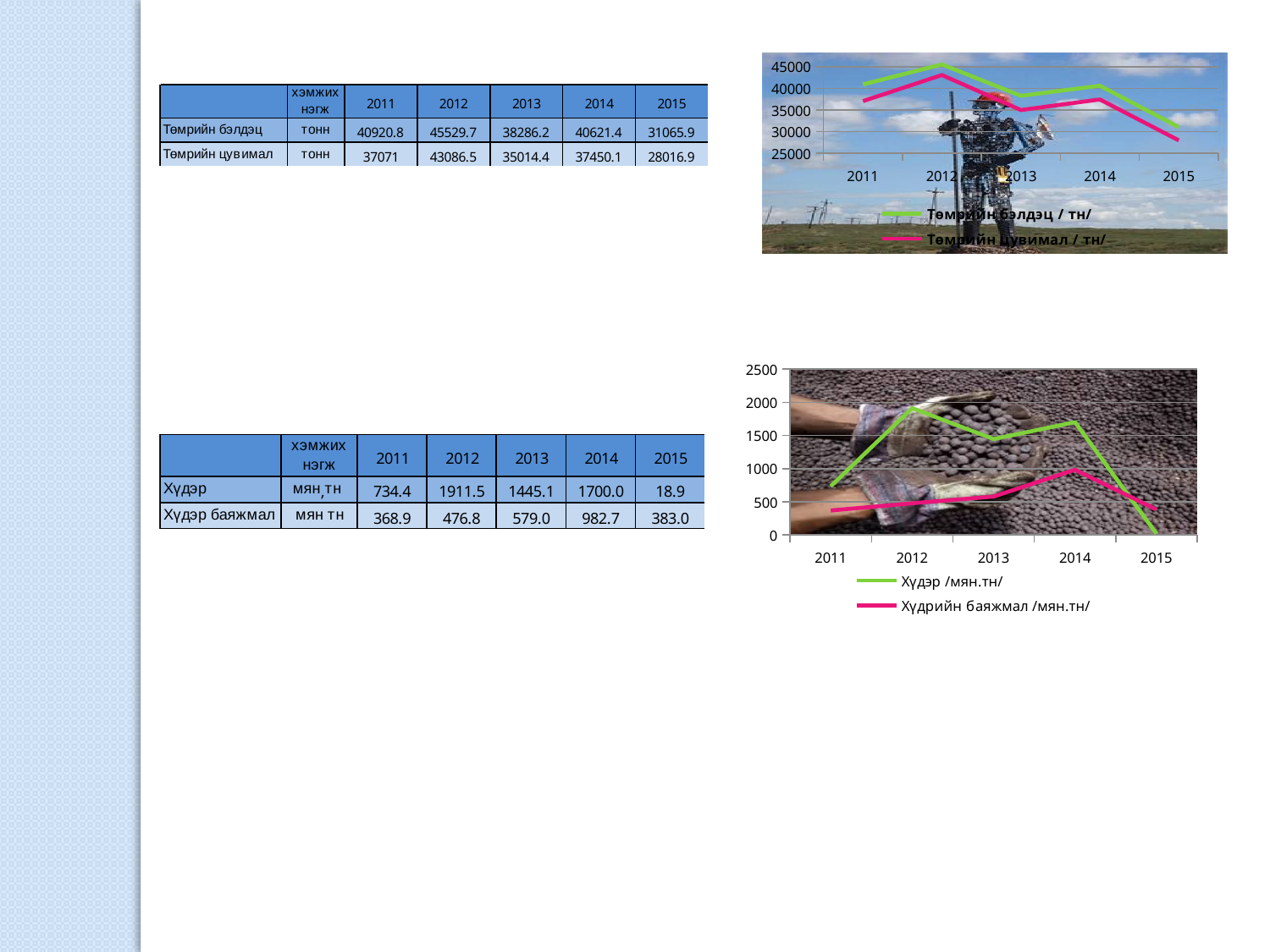
According to the table for the bottom chart, what is the value of Хүдэр in 2014? 1700.0 Using the table for the bottom chart, what is the difference between Хүдэр баяжмал in 2014 and in 2013? 403.7 In the bottom chart, in which year is Хүдэр /мян.тн/ at its lowest? 2015 In the top chart, in which year does Төмрийн бэлдэц /тн/ reach its highest value? 2012 How many series does the legend of the top chart list? 2 How many years are shown on the x axis of the bottom chart? 5 In the top chart, which series has the larger value in 2012, Төмрийн бэлдэц /тн/ or Төмрийн цувимал /тн/? Төмрийн бэлдэц /тн/ In the bottom chart, does Хүдрийн баяжмал /мян.тн/ rise or fall from 2011 to 2014? rise In the bottom chart, is the value for Хүдэр /мян.тн/ in 2012 greater or less than 1500? greater What kind of chart is the top chart on the slide? line chart In the bottom chart, in which year does Хүдрийн баяжмал /мян.тн/ reach its highest value? 2014 In the top chart, is the value for Төмрийн цувимал /тн/ in 2015 greater or less than 30000? less